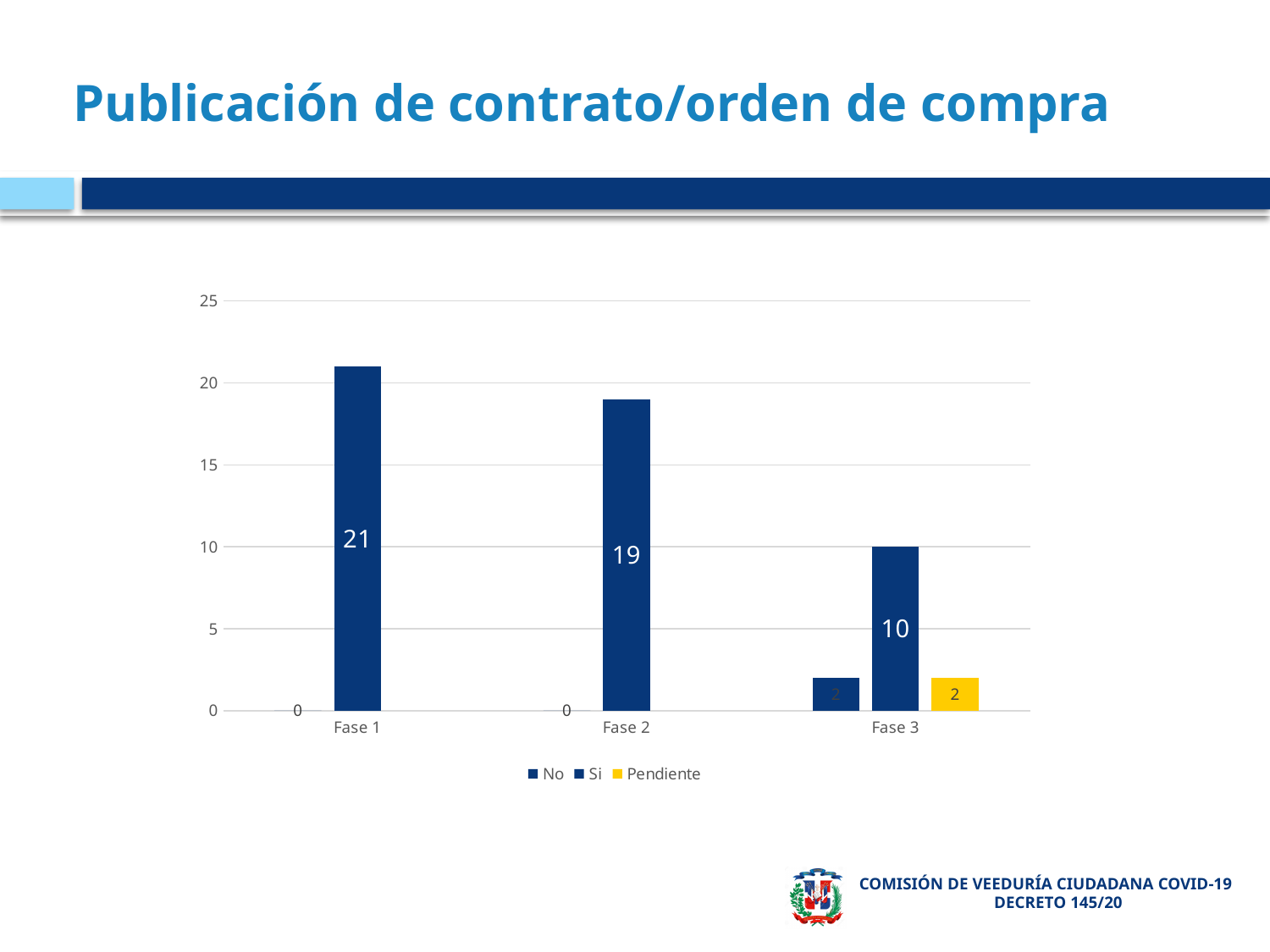
What is the value of the Si series for Fase 1? 21 What is the value of the Pendiente series for Fase 3? 2 Which phase has the lowest value for the Si series? Fase 3 What is the value of the Si series for Fase 3? 10 Do the Si values rise or fall from Fase 1 to Fase 3? fall What is the value of the No series for Fase 1? 0 How many phases (categories) are shown on the x axis? 3 How many series does the legend list? 3 What is the value of the Si series for Fase 2? 19 What is the difference between the Si values for Fase 1 and Fase 2? 2 Which phase has the highest value for the Si series? Fase 1 Which is larger: the Si value for Fase 2 or the Si value for Fase 3? Fase 2